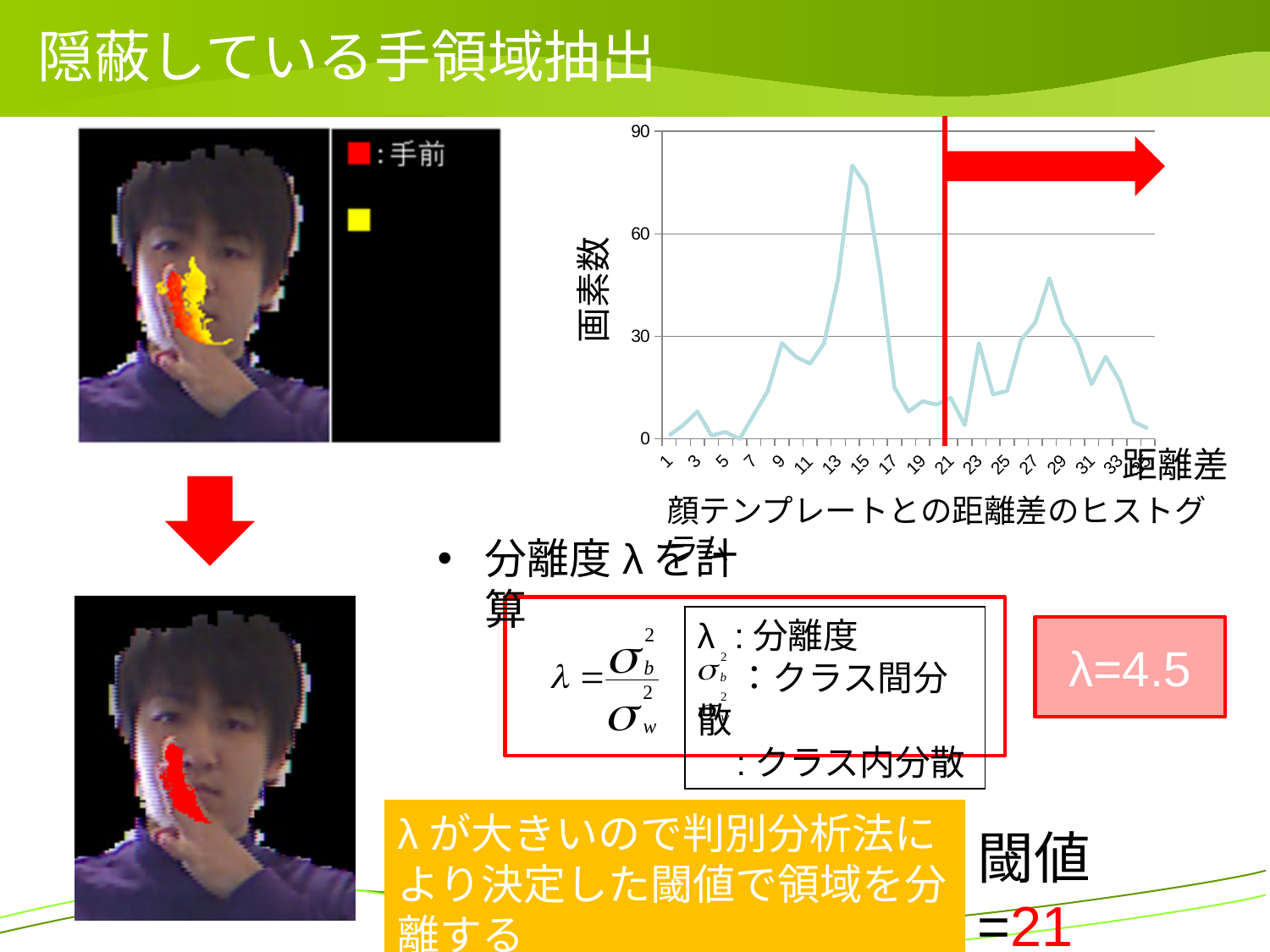
What kind of chart is shown on the slide? line chart Is the value at 距離差 15 greater or less than 60? greater What is the label of the horizontal axis of the chart? 距離差 What is the label of the vertical axis of the chart? 画素数 Is the value at 距離差 33 greater or less than 30? less Between 距離差 15 and 距離差 21, do the values rise or fall? fall Which has the larger value, 距離差 5 or 距離差 15? 15 Which has the larger value, 距離差 15 or 距離差 29? 15 Is the value at 距離差 1 greater or less than 30? less